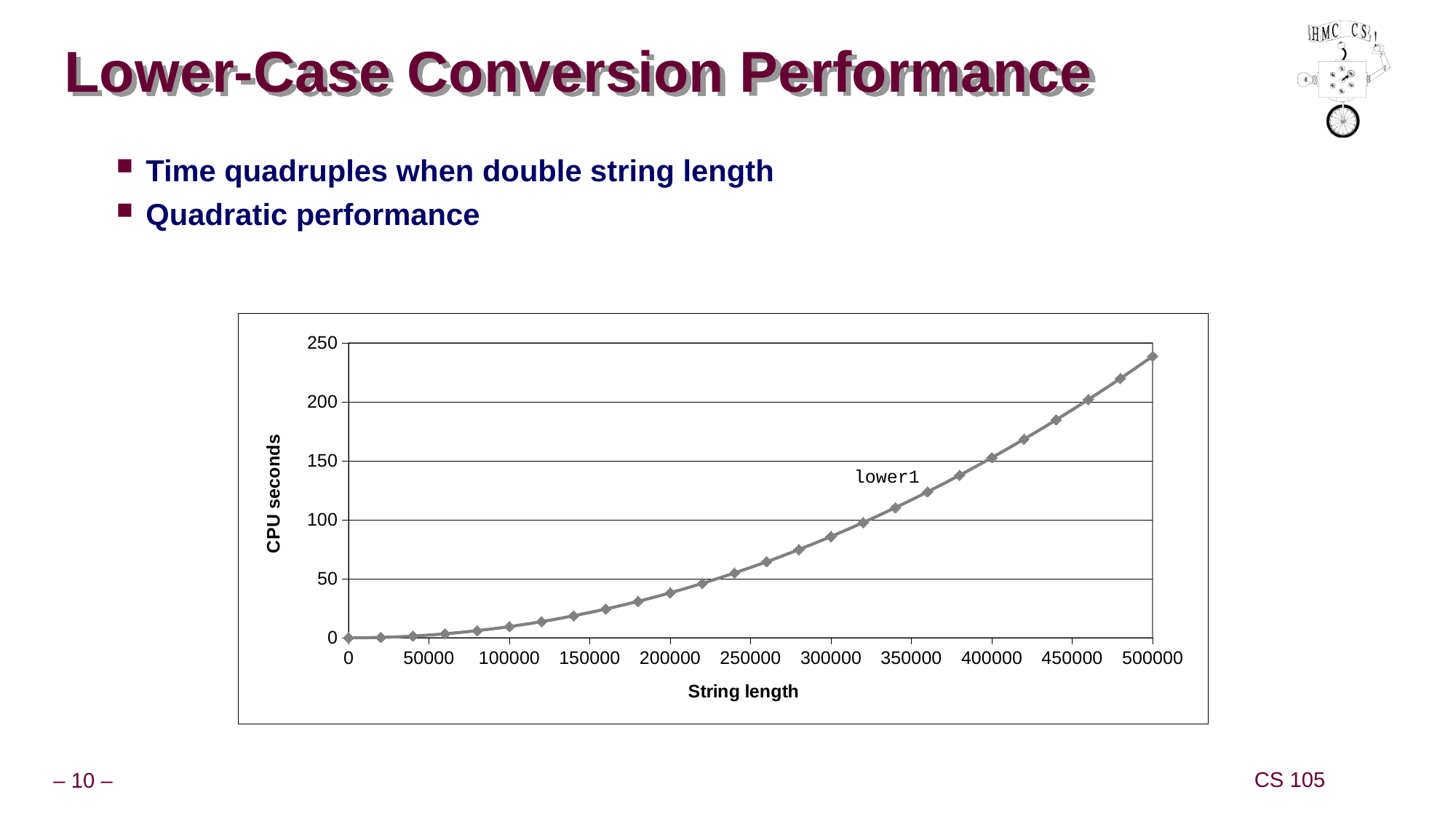
At which string length is the CPU time highest? 500000 Which has a larger CPU seconds value: string length 200000 or string length 300000? 300000 Is the CPU seconds value at string length 400000 greater or less than 100? greater Is the CPU seconds value at string length 500000 greater or less than 200? greater What is the label of the x axis? String length Do the CPU seconds rise or fall as string length increases? rise Is the CPU seconds value at string length 100000 greater or less than 50? less What kind of chart is shown on the slide? line chart What is the label of the y axis? CPU seconds How many data series are plotted in the chart? 1 What is the name of the series plotted in the chart? lower1 At which string length is the CPU time lowest? 0